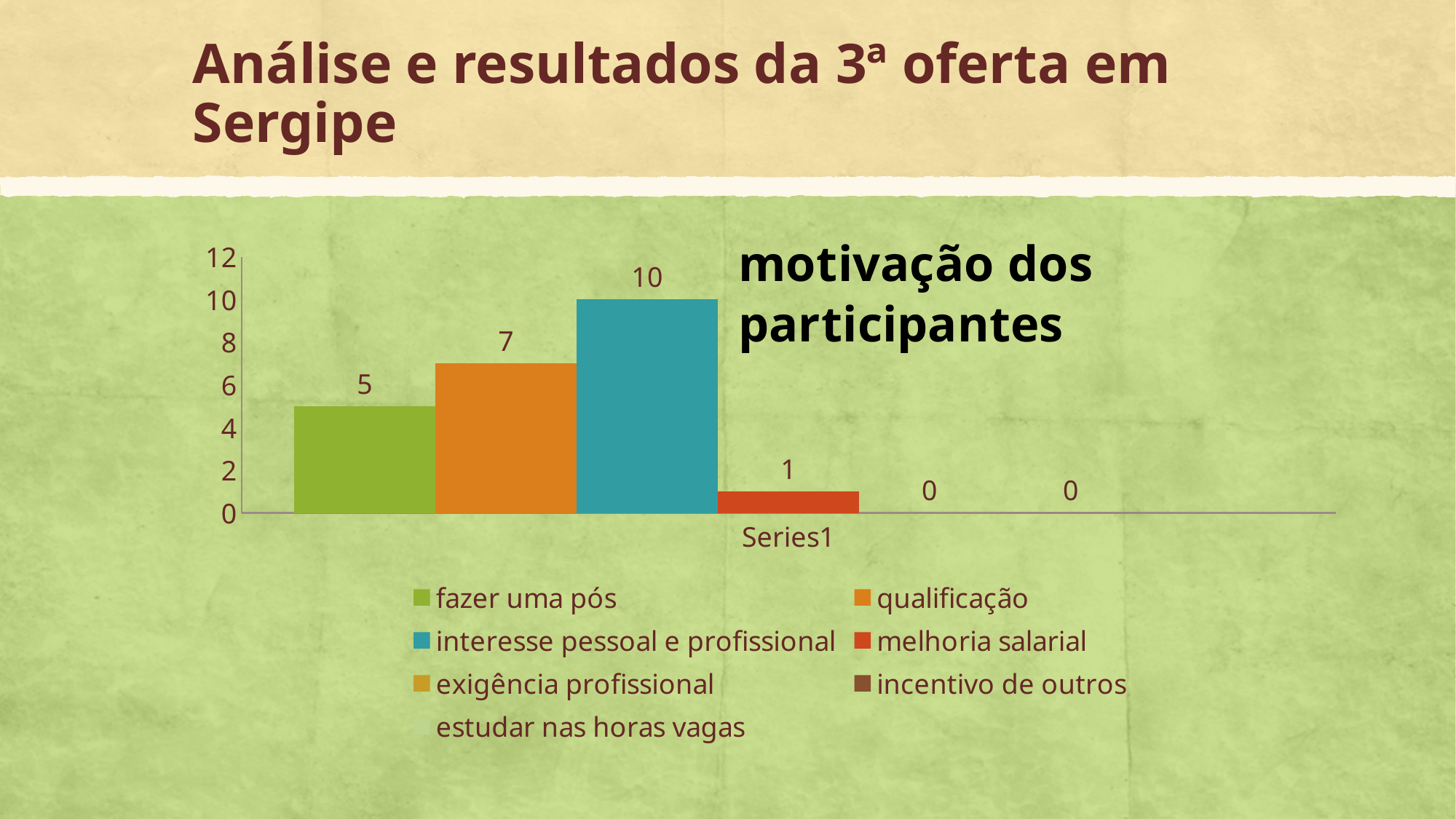
Is the value for 'interesse pessoal e profissional' greater or less than 8? greater What is the difference between the values for 'interesse pessoal e profissional' and 'qualificação'? 3 What kind of chart is shown on the slide? bar chart How many series does the legend list? 7 What is the value for 'interesse pessoal e profissional' in the chart? 10 What is the value for 'exigência profissional' in the chart? 0 What is the difference between the values for 'qualificação' and 'fazer uma pós'? 2 What is the value for 'qualificação' in the chart? 7 Which is larger, the value for 'fazer uma pós' or the value for 'qualificação'? qualificação Which series has the highest value in the chart? interesse pessoal e profissional What is the value for 'fazer uma pós' in the chart? 5 What is the value for 'melhoria salarial' in the chart? 1